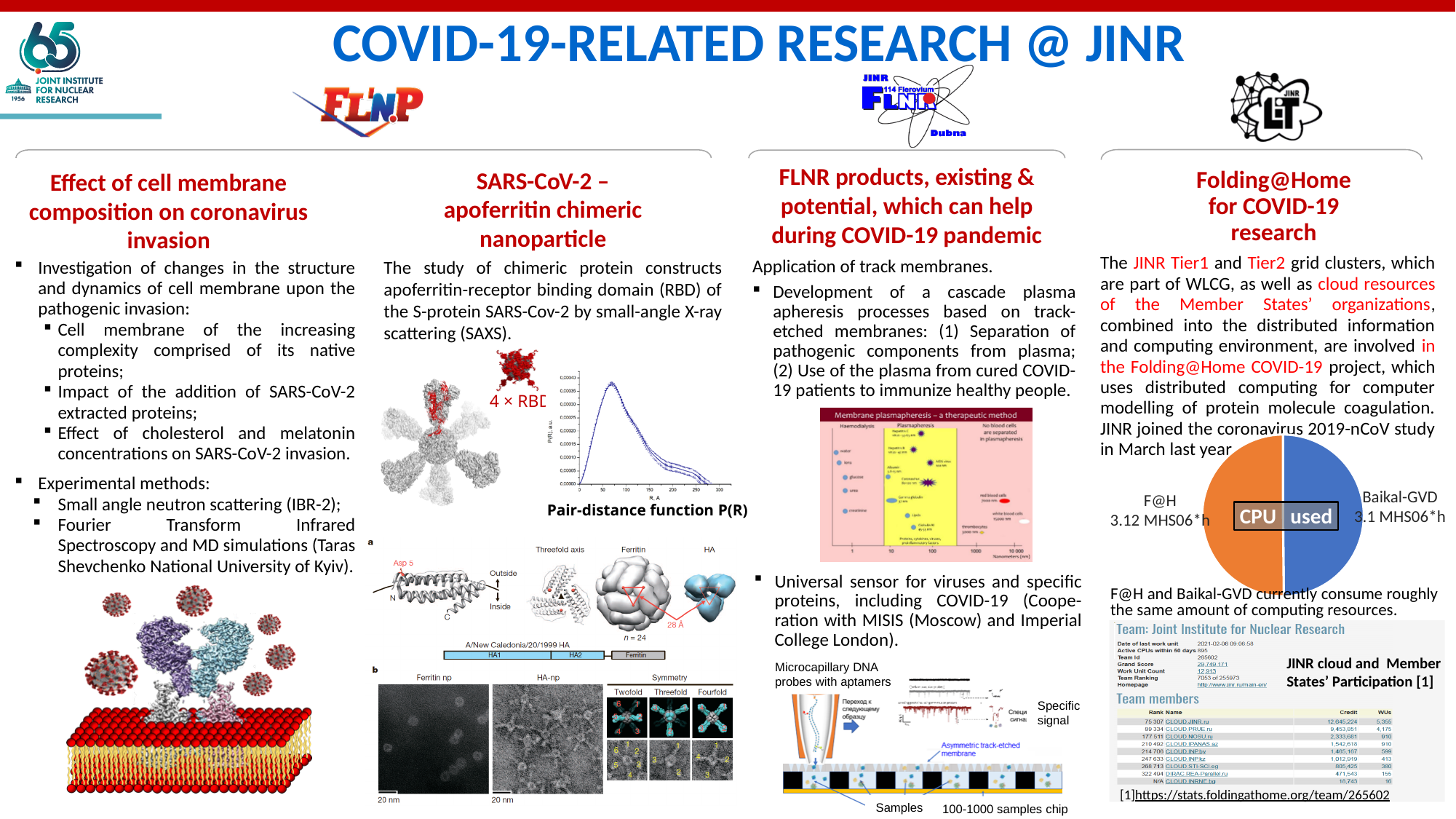
How many slices does the 'CPU used' pie chart have? 2 What kind of chart is the 'Pair-distance function P(R)' chart in the second column? line chart In the 'CPU used' pie chart, what is the difference between the F@H and Baikal-GVD values? 0.02 MHS06*h In the 'CPU used' pie chart, what is the value for F@H? 3.12 MHS06*h What kind of chart is the 'CPU used' chart on the right side of the slide? pie chart In the 'CPU used' pie chart, which has the larger value, F@H or Baikal-GVD? F@H What is the title shown in the centre of the pie chart on the right side of the slide? CPU used In the 'CPU used' pie chart, what is the value for Baikal-GVD? 3.1 MHS06*h In the 'CPU used' pie chart, what colour is the F@H slice? orange In the 'CPU used' pie chart, which slice has the smallest value? Baikal-GVD